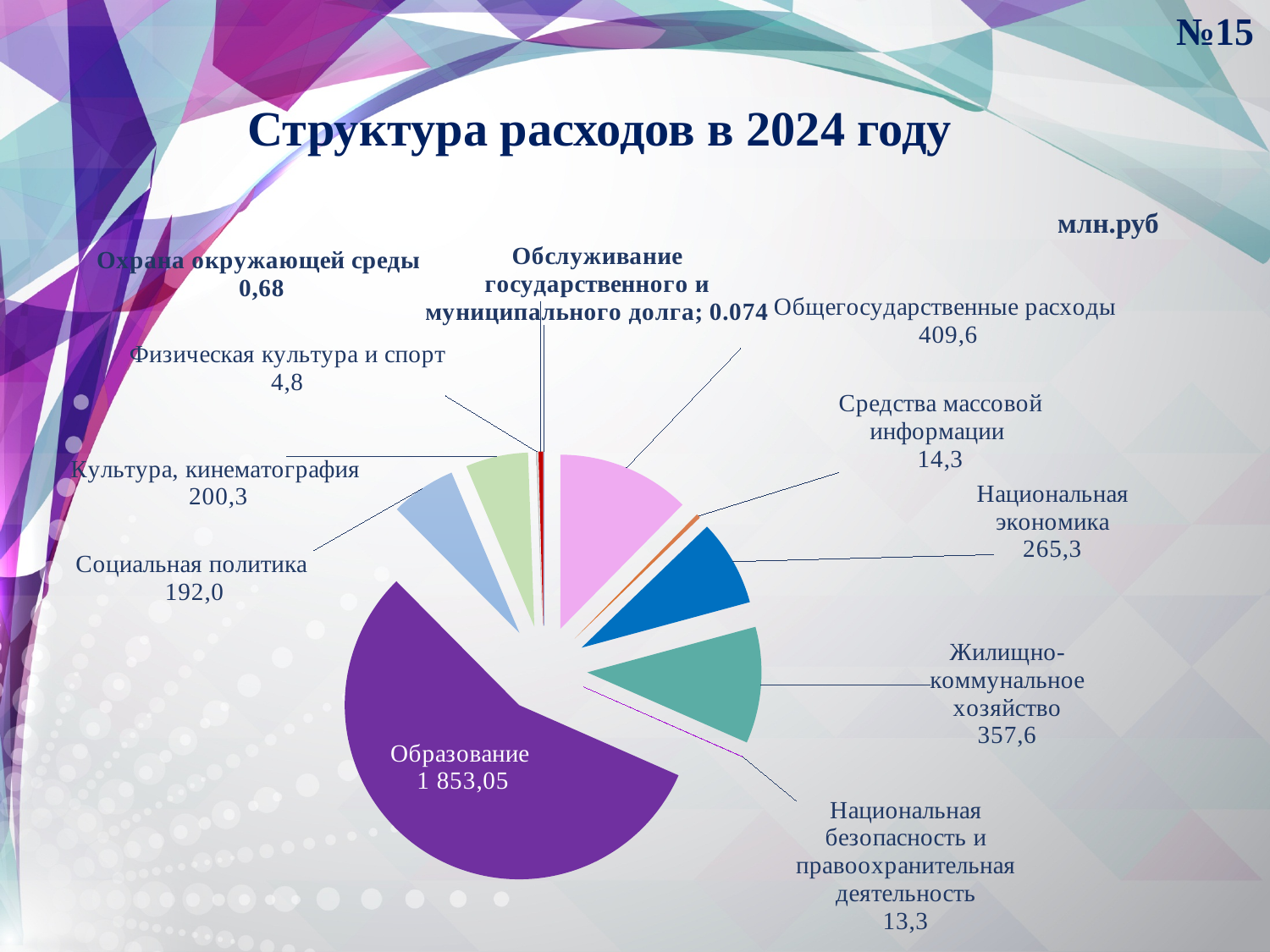
Which category has the smallest value? Обслуживание государственного и муниципального долга What is the value for Жилищно-коммунальное хозяйство? 357,6 Which is larger, Культура, кинематография or Социальная политика? Культура, кинематография What is the difference between Национальная экономика and Социальная политика? 73,3 What is the value for Национальная безопасность и правоохранительная деятельность? 13,3 What is the value for Образование? 1 853,05 What is the value for Общегосударственные расходы? 409,6 How many categories does the pie chart show? 11 What kind of chart is shown on the slide? pie chart What is the difference between Общегосударственные расходы and Жилищно-коммунальное хозяйство? 52,0 Which category has the largest value? Образование What unit is indicated for the values on the chart? млн.руб